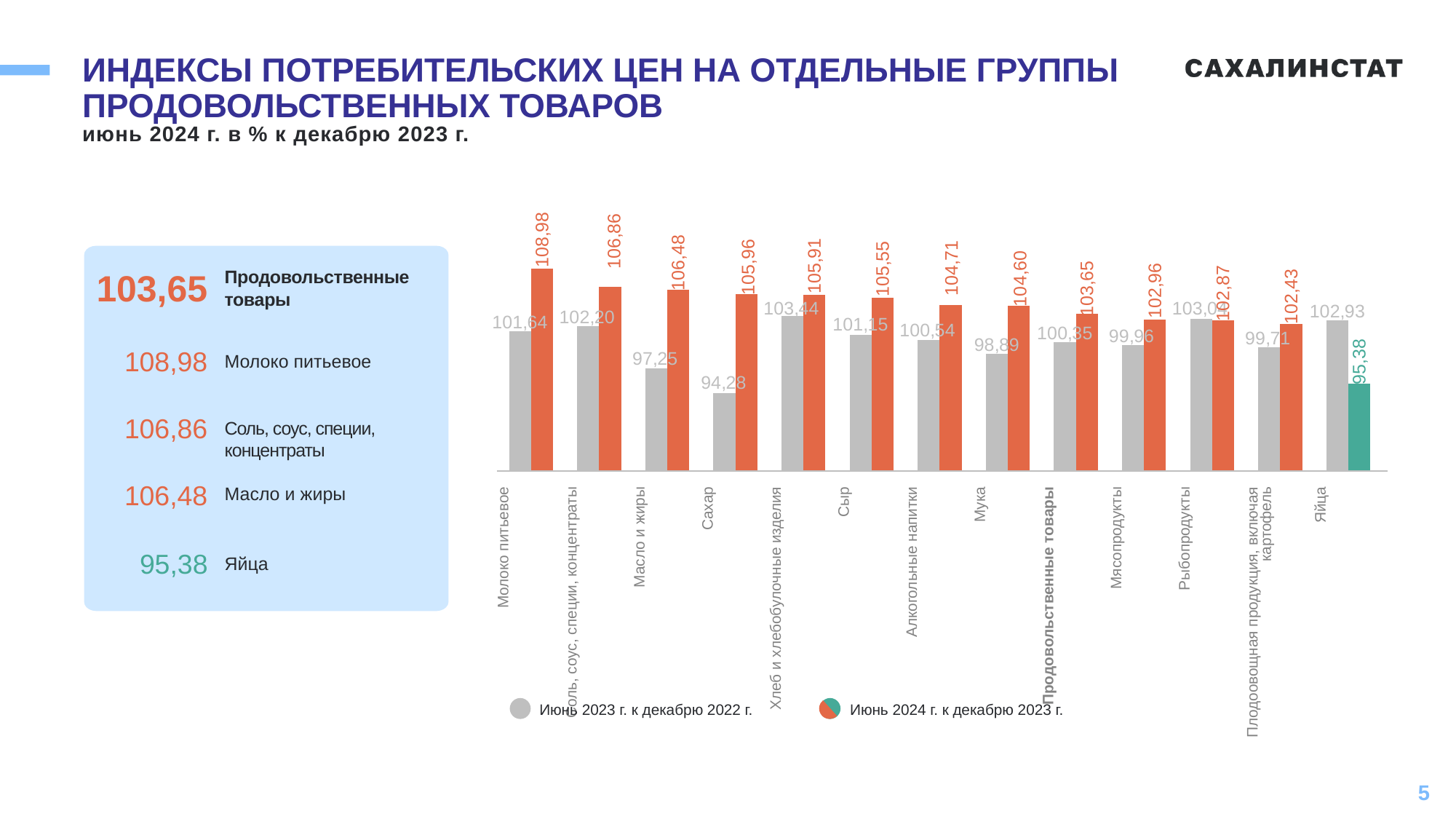
What is the difference between the Июнь 2024 г. к декабрю 2023 г. and Июнь 2023 г. к декабрю 2022 г. values for Сахар? 11,68 Which category has the lowest value in the series Июнь 2023 г. к декабрю 2022 г.? Сахар What is the value for Молоко питьевое in the series Июнь 2024 г. к декабрю 2023 г.? 108,98 What type of chart is shown on the slide? bar chart Which category has the highest value in the series Июнь 2024 г. к декабрю 2023 г.? Молоко питьевое What is the value for Яйца in the series Июнь 2024 г. к декабрю 2023 г.? 95,38 What colour is the bar for Яйца in the series Июнь 2024 г. к декабрю 2023 г.? green How many product categories are shown on the x axis of the chart? 13 What is the value for Сахар in the series Июнь 2023 г. к декабрю 2022 г.? 94,28 What is the value for Продовольственные товары in the series Июнь 2024 г. к декабрю 2023 г.? 103,65 For Яйца, which series has the larger value: Июнь 2023 г. к декабрю 2022 г. or Июнь 2024 г. к декабрю 2023 г.? Июнь 2023 г. к декабрю 2022 г. How many series does the chart legend list? 2